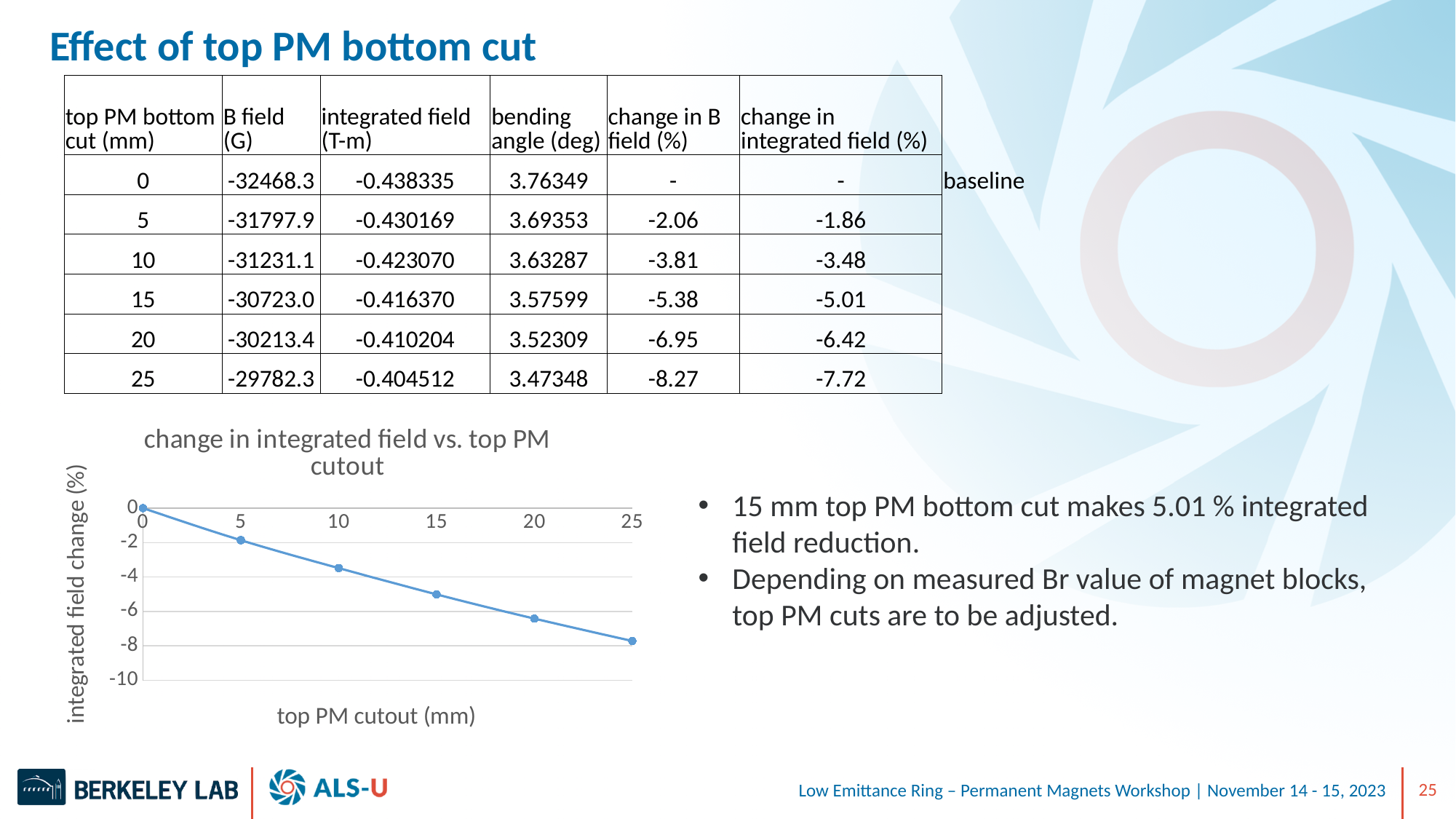
What is the integrated field change at a top PM cutout of 0 mm? 0 What kind of chart is shown on the slide? line chart Which top PM cutout value has the highest integrated field change on the chart? 0 What is the x-axis label of the chart? top PM cutout (mm) What is the title of the chart? change in integrated field vs. top PM cutout Is the integrated field change at a top PM cutout of 25 mm greater or less than -6? less Is the integrated field change at a top PM cutout of 5 mm greater or less than -4? greater Is the integrated field change at a top PM cutout of 15 mm greater or less than -4? less Which top PM cutout value has the lowest integrated field change on the chart? 25 Do the plotted values rise or fall as the top PM cutout increases along the x axis? fall How many data points are plotted on the chart? 6